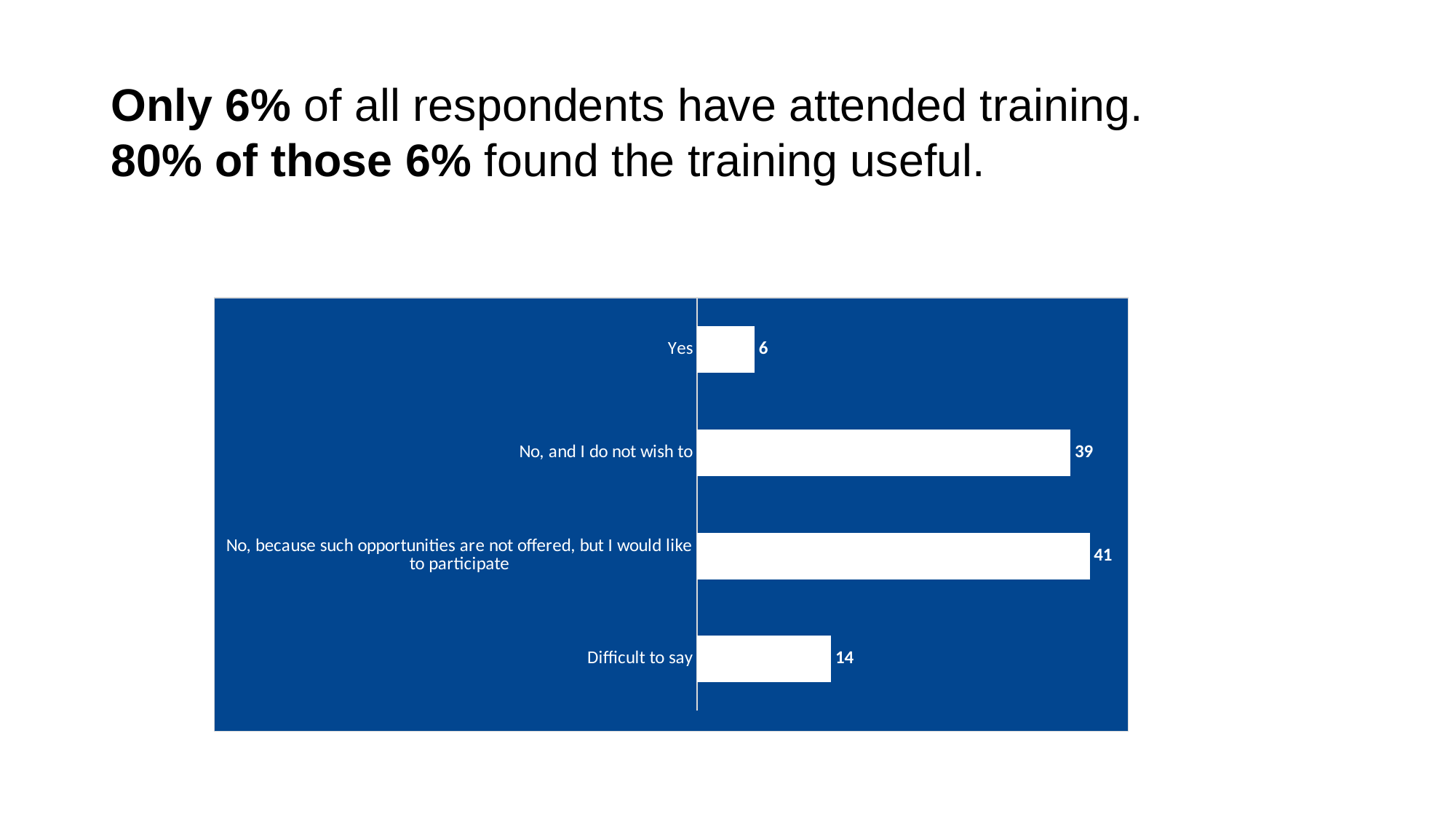
What is the difference between the values for "No, and I do not wish to" and "Difficult to say"? 25 What colour are the bars in the chart? White What kind of chart is shown on the slide? Bar chart Which category has the highest value? No, because such opportunities are not offered, but I would like to participate What is the value for "Yes"? 6 What is the difference between the values for "No, because such opportunities are not offered, but I would like to participate" and "Yes"? 35 What is the value for "Difficult to say"? 14 What is the value for "No, because such opportunities are not offered, but I would like to participate"? 41 How many categories are shown in the chart? 4 Which is larger, the value for "Difficult to say" or the value for "Yes"? Difficult to say What is the value for "No, and I do not wish to"? 39 Which category has the lowest value? Yes